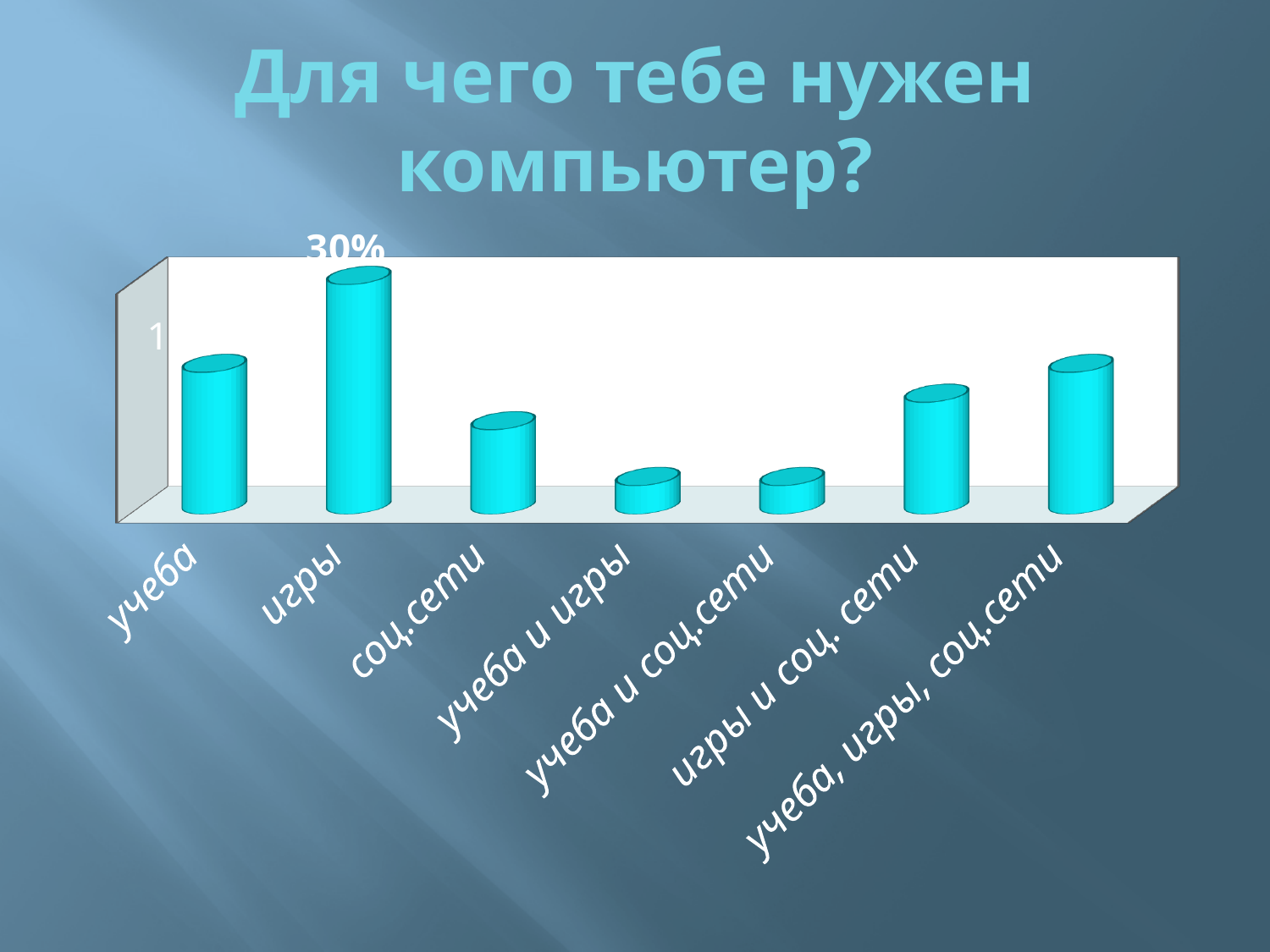
How many categories are shown on the x axis of the chart? 7 What is the title of the slide? Для чего тебе нужен компьютер? Which category has the highest bar? игры Which is larger, the value for учеба or the value for соц.сети? учеба What kind of chart is shown on the slide? bar chart Which is larger, the value for игры or the value for учеба? игры What is the value shown for игры? 30% What colour are the bars in the chart? cyan Which is larger, the value for игры и соц. сети or the value for учеба и соц.сети? игры и соц. сети